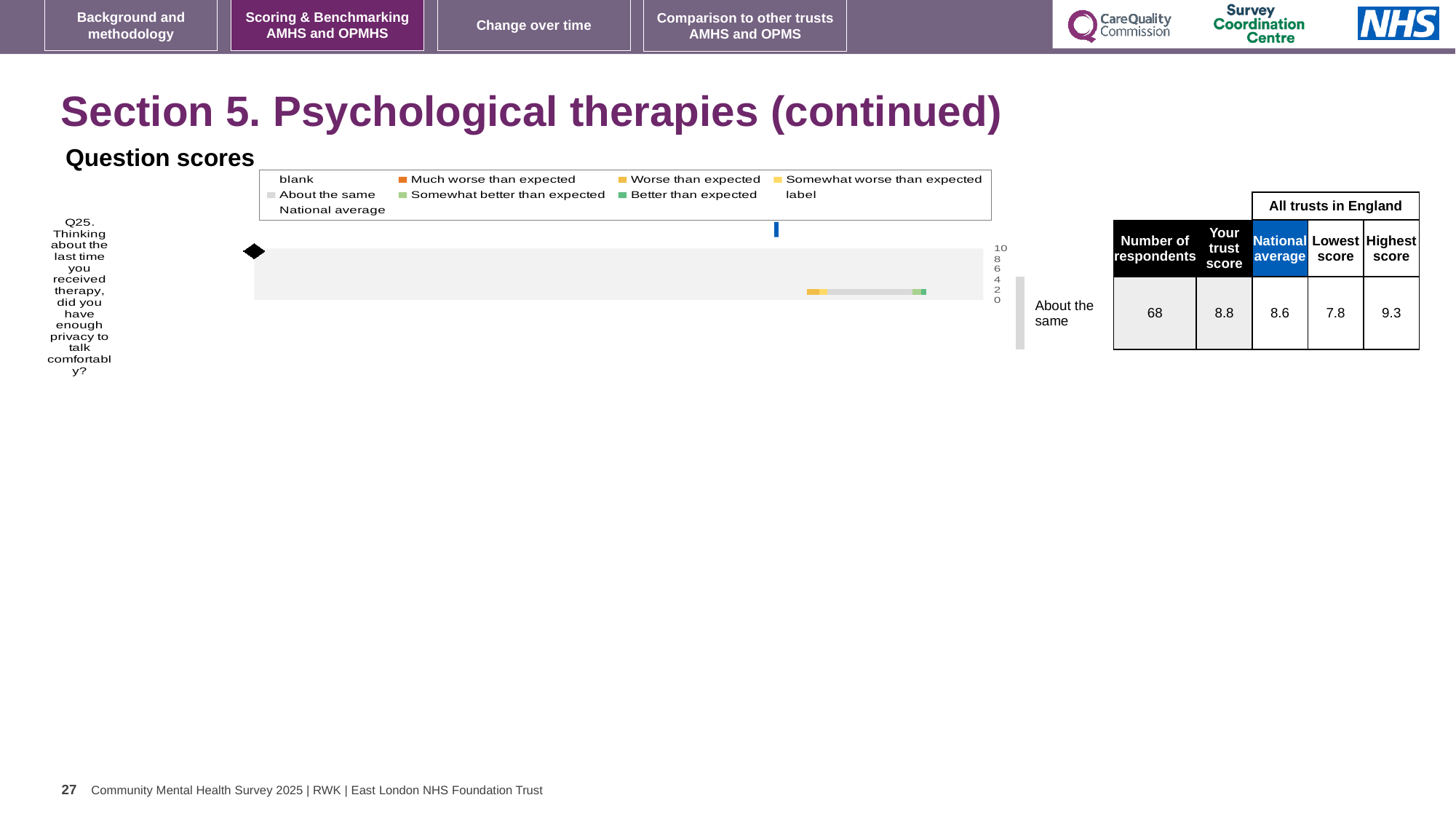
How many entries does the legend of the Question scores chart list? 9 What kind of chart is shown under 'Question scores'? bar chart In the table beside the chart, what is the Highest score for Q25? 9.3 Which question number is plotted in the Question scores chart? Q25 What benchmark category is shown next to the bar for Q25? About the same In the table beside the chart, what is the Lowest score for Q25? 7.8 In the table beside the chart, what is the National average for Q25? 8.6 For Q25, which is larger: Your trust score or the National average? Your trust score In the table beside the chart, what is the Number of respondents for Q25? 68 For Q25, what is the difference between the Highest score and the Lowest score? 1.5 How many questions are plotted in the Question scores chart? 1 In the table beside the chart, what is 'Your trust score' for Q25? 8.8